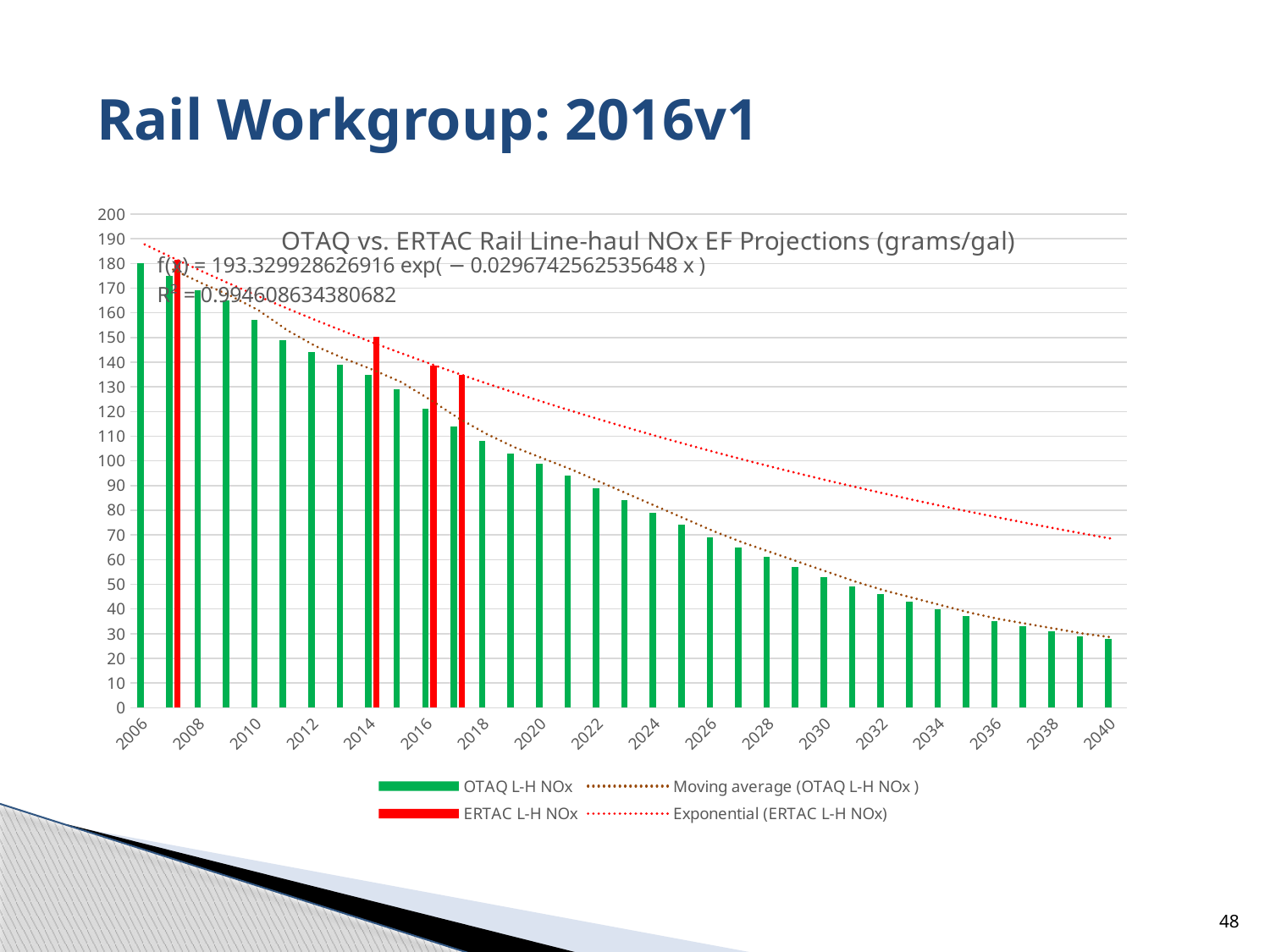
In 2014, which is larger: the OTAQ L-H NOx value or the ERTAC L-H NOx value? ERTAC L-H NOx Is the ERTAC L-H NOx value for 2014 greater or less than 140? greater Which year has the lowest OTAQ L-H NOx value? 2040 Is the OTAQ L-H NOx value for 2006 greater or less than 170? greater Is the OTAQ L-H NOx value for 2040 greater or less than 40? less What kind of chart is shown on the slide? bar chart How many years have an ERTAC L-H NOx (red) bar? 4 Which is larger: the OTAQ L-H NOx value for 2010 or for 2030? 2010 What is the title of the chart? OTAQ vs. ERTAC Rail Line-haul NOx EF Projections (grams/gal) Do the OTAQ L-H NOx values rise or fall from 2006 to 2040? fall Which year has the highest OTAQ L-H NOx value? 2006 How many entries does the chart legend list? 4